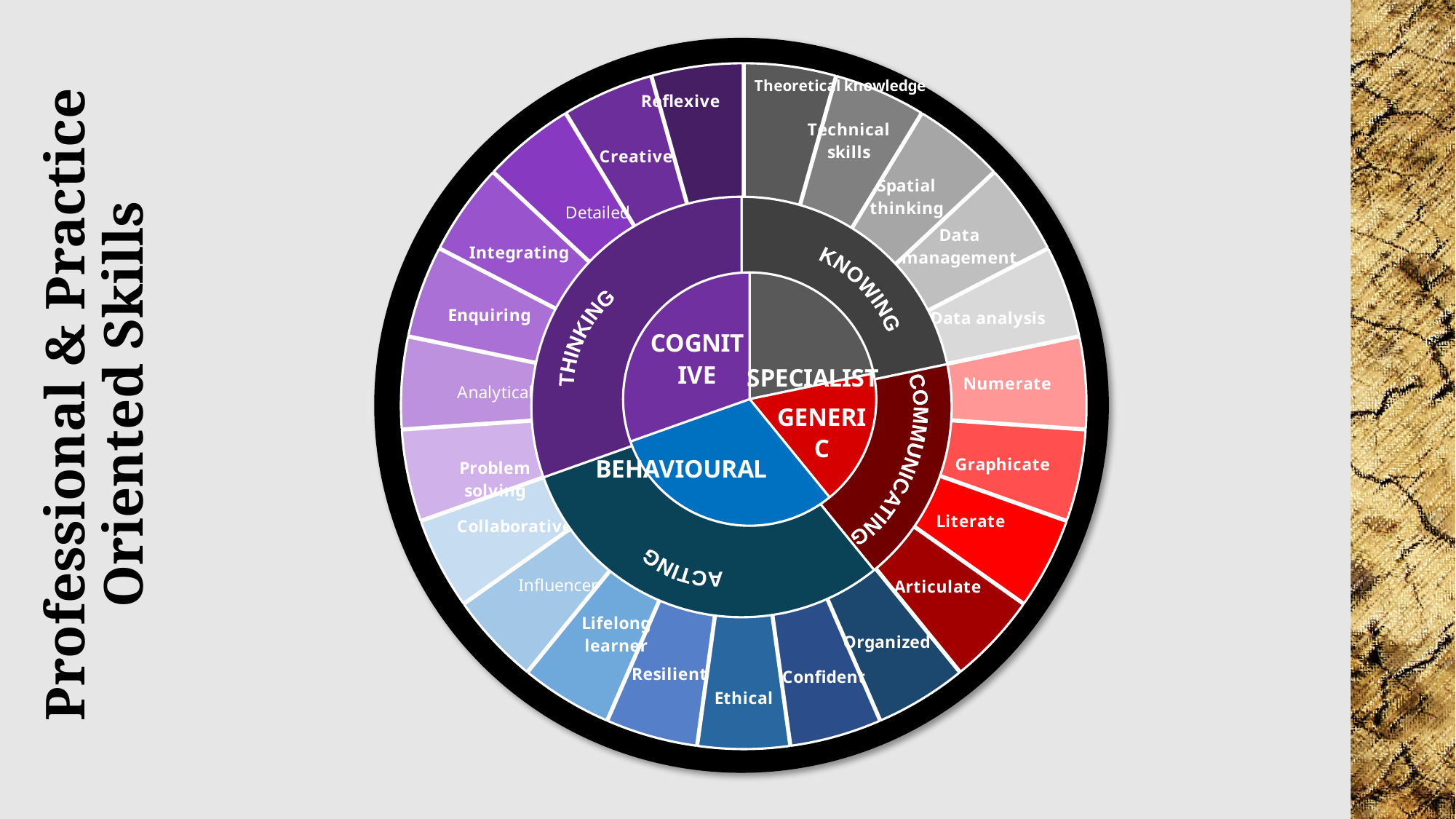
How many skill segments are in the outer ring under the COGNITIVE section? 7 What kind of chart is shown on the slide? Sunburst chart Which inner-ring segment occupies the smallest share of the chart? GENERIC Which middle-ring label belongs to the GENERIC segment? COMMUNICATING How many skill segments are in the outer ring under the SPECIALIST section? 5 How many segments are in the innermost ring of the chart? 4 Which inner-ring segment is larger, COGNITIVE or GENERIC? COGNITIVE What colour is used for the BEHAVIOURAL section of the chart? Blue Which middle-ring label sits between the COGNITIVE segment and its outer skills? THINKING What is the title of the slide? Professional & Practice Oriented Skills